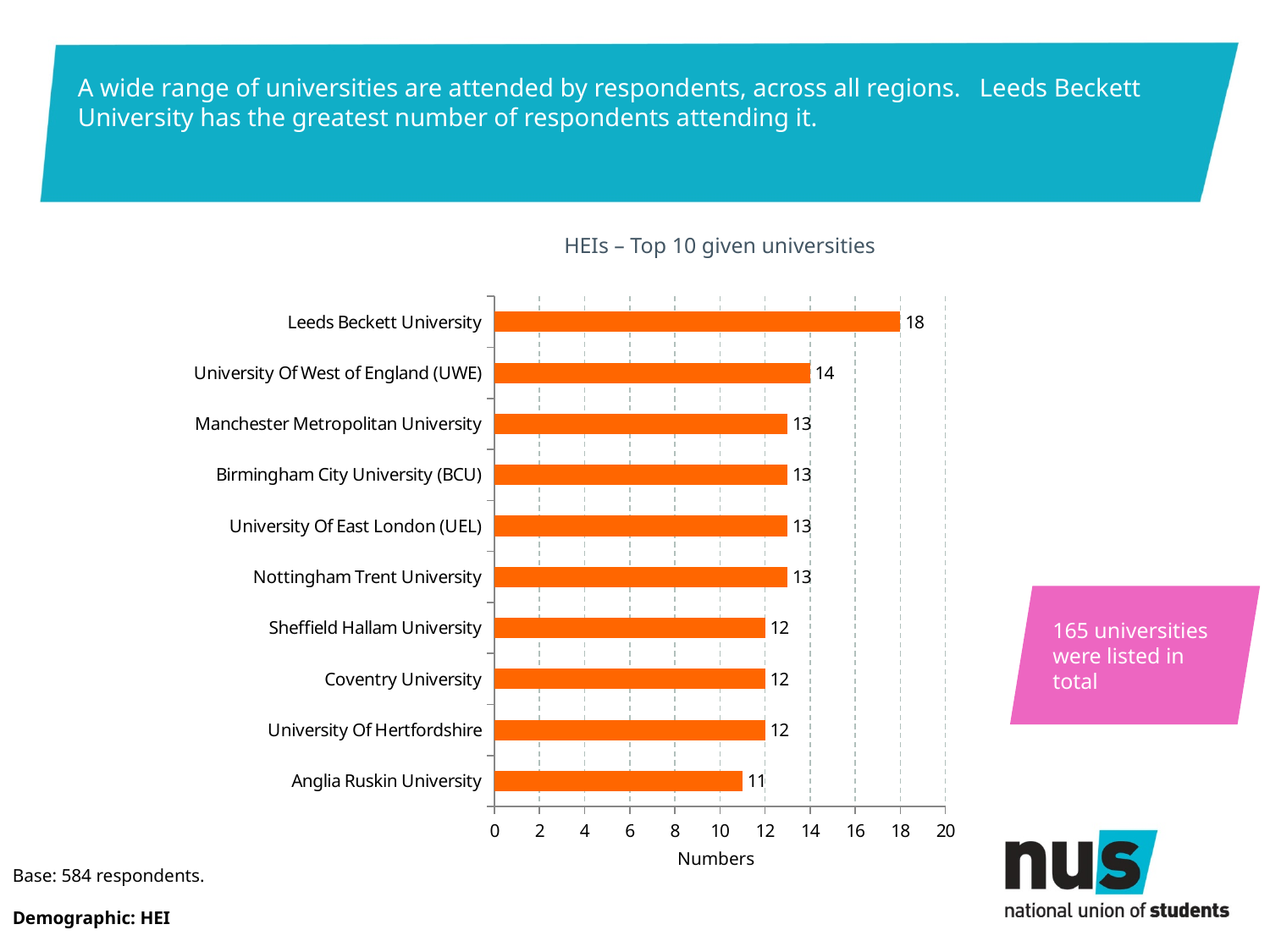
Which is larger, the value for Nottingham Trent University or the value for University Of Hertfordshire? Nottingham Trent University What is the value for Sheffield Hallam University? 12 What kind of chart is shown on the slide? Bar chart Which university has the lowest value? Anglia Ruskin University How many universities are shown in the chart? 10 What is the title of the chart? HEIs – Top 10 given universities What is the difference between the values for University Of West of England (UWE) and Coventry University? 2 Which university has the highest value? Leeds Beckett University What is the value for University Of West of England (UWE)? 14 What is the difference between the values for Leeds Beckett University and Anglia Ruskin University? 7 What is the value for Leeds Beckett University? 18 What is the value for Anglia Ruskin University? 11